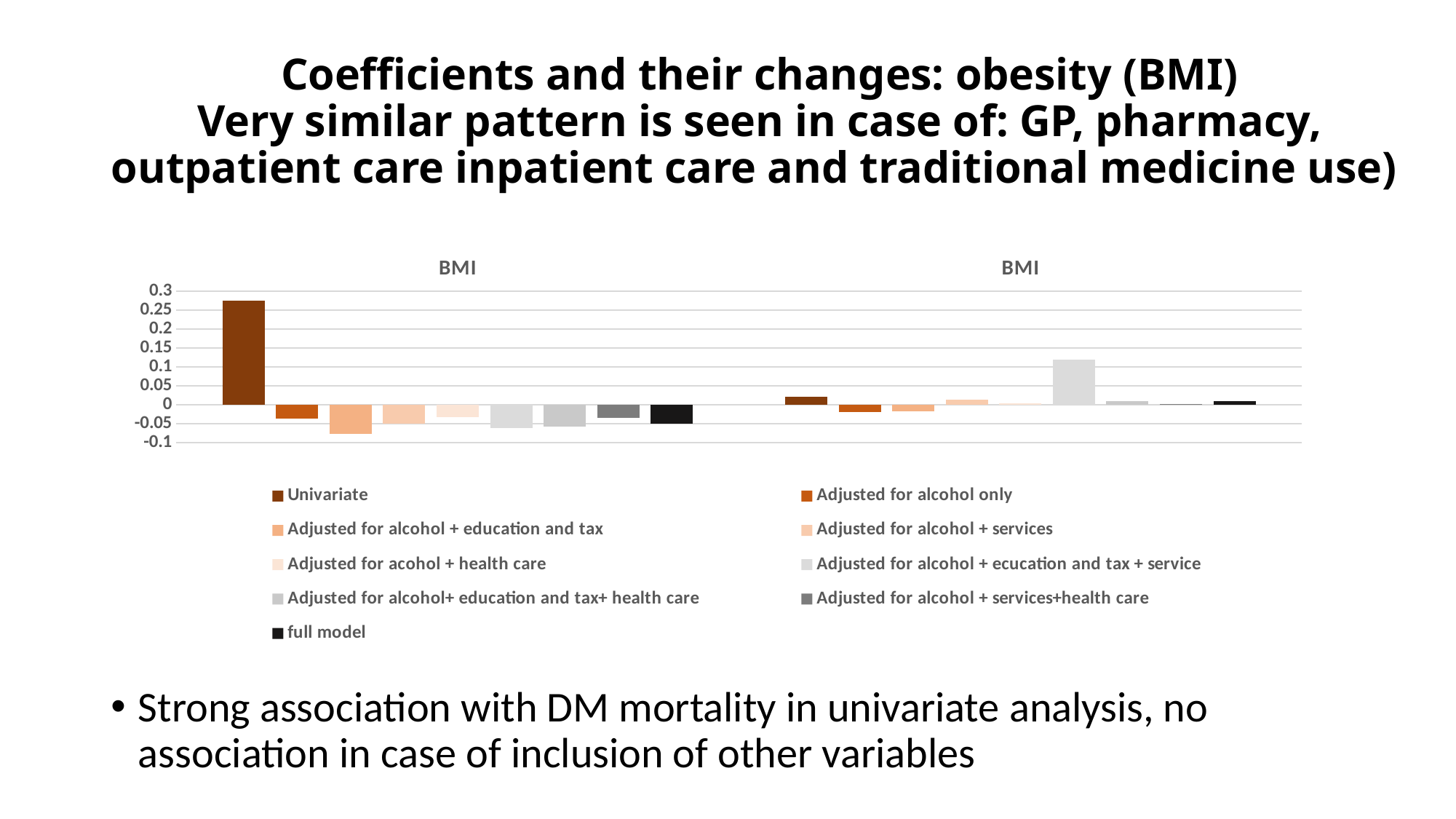
Which series has the highest value in the left BMI group? Univariate What kind of chart is shown on the slide? bar chart Is the Univariate value in the left BMI group greater or less than 0.3? less What is the title shown above each group of bars in the chart? BMI Is the value for 'Adjusted for alcohol + ecucation and tax + service' in the right BMI group greater or less than 0.05? greater Which series has the highest value in the right BMI group? Adjusted for alcohol + ecucation and tax + service Is the value for 'Adjusted for alcohol + education and tax' in the left BMI group greater or less than -0.05? less Which series has the lowest value in the left BMI group? Adjusted for alcohol + education and tax How many series does the legend list? 9 Which is larger: the Univariate value in the left BMI group or the Univariate value in the right BMI group? the left BMI group How many category groups are plotted along the x axis? 2